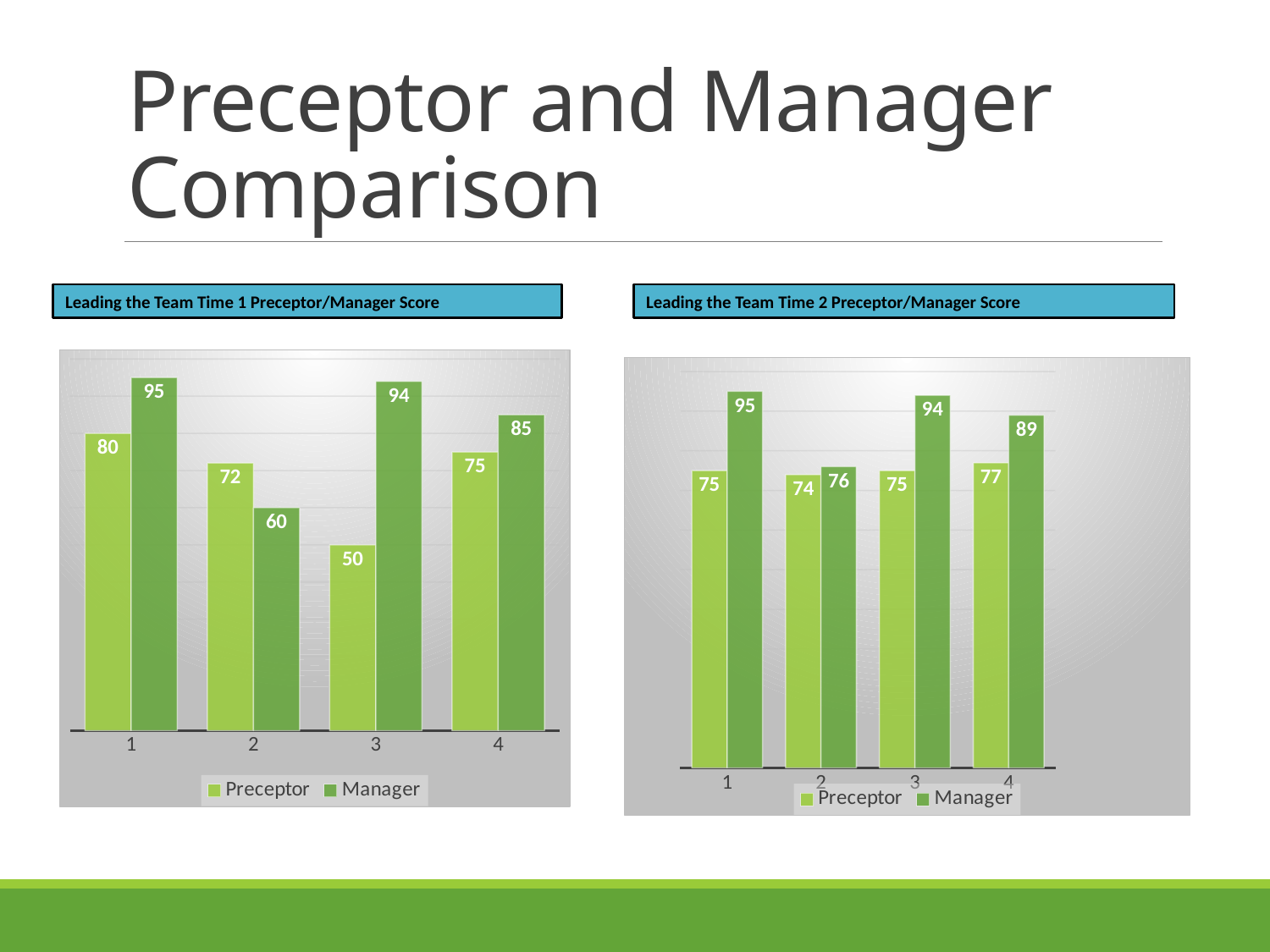
In the Time 1 chart, what is the Preceptor score for category 2? 72 In the Time 2 chart, what is the Preceptor score for category 2? 74 In the Time 2 chart, what is the difference between the Manager and Preceptor scores for category 1? 20 How many categories are shown on the x axis of the Time 1 chart? 4 In the Time 1 chart, which is larger for category 2: the Preceptor score or the Manager score? Preceptor In the Time 2 chart, what is the Manager score for category 4? 89 In the Time 1 chart, what is the difference between the Manager and Preceptor scores for category 3? 44 In the Time 1 chart, what is the Manager score for category 3? 94 How many series does the legend of the Time 2 chart list? 2 What kind of chart is the Time 2 chart? Bar chart In the Time 1 chart, which category has the highest Manager score? 1 In the Time 1 chart, which category has the lowest Preceptor score? 3